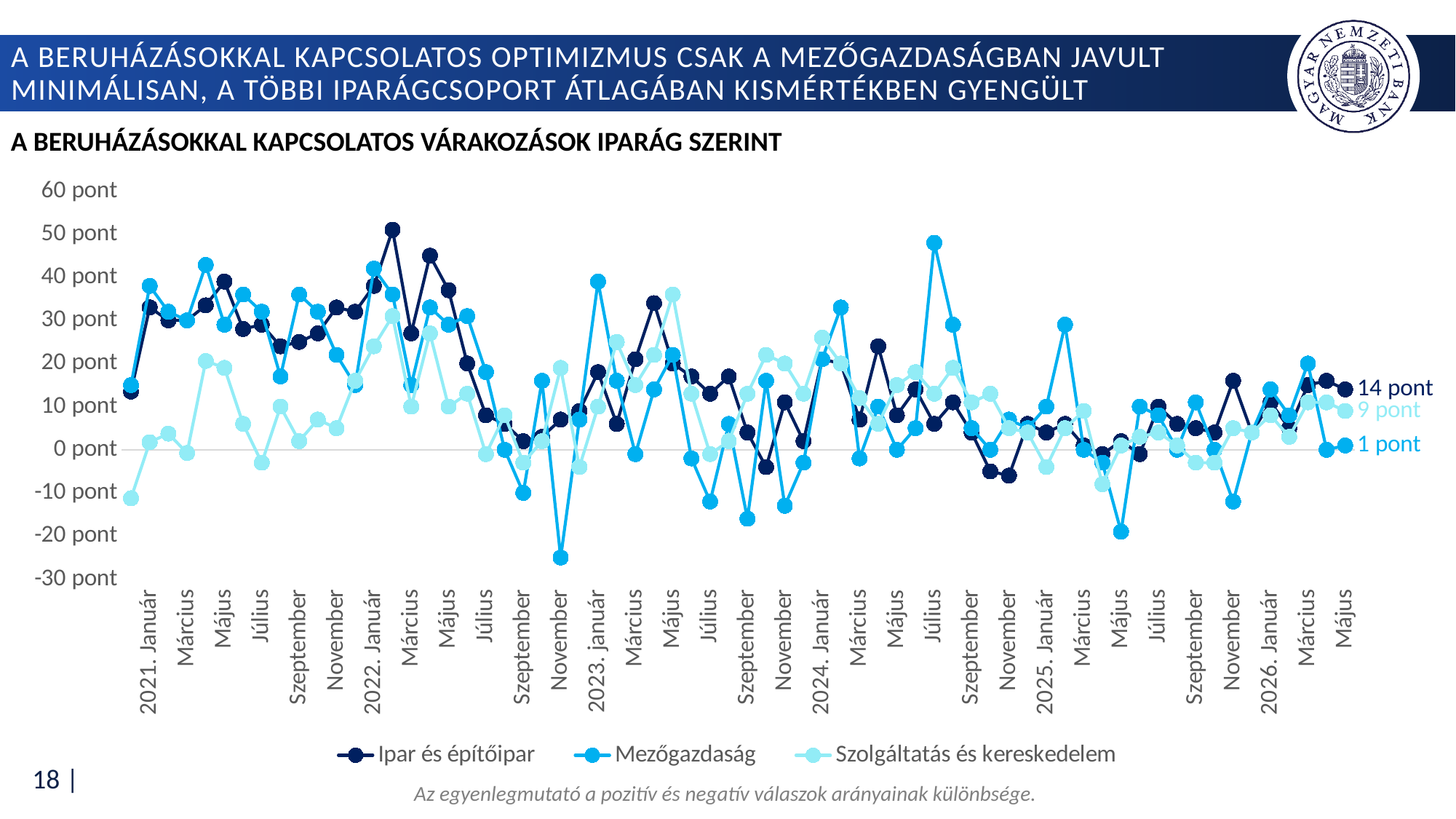
Is the value for Mezőgazdaság in 2022 November greater or less than -20 pont? less Is the value for Mezőgazdaság in 2024 Július greater or less than 40 pont? greater What kind of chart is shown on the slide? line chart What is the title of the chart? A BERUHÁZÁSOKKAL KAPCSOLATOS VÁRAKOZÁSOK IPARÁG SZERINT What is the difference between the latest values of Ipar és építőipar and Szolgáltatás és kereskedelem? 5 pont What is the latest value shown for Mezőgazdaság? 1 pont What is the latest value shown for Ipar és építőipar? 14 pont Which series has the highest value at the end of the chart (2026 Május)? Ipar és építőipar What is the difference between the latest values of Ipar és építőipar and Mezőgazdaság? 13 pont What is the latest value shown for Szolgáltatás és kereskedelem? 9 pont How many series does the legend list? 3 Which series has the lowest value at the end of the chart (2026 Május)? Mezőgazdaság